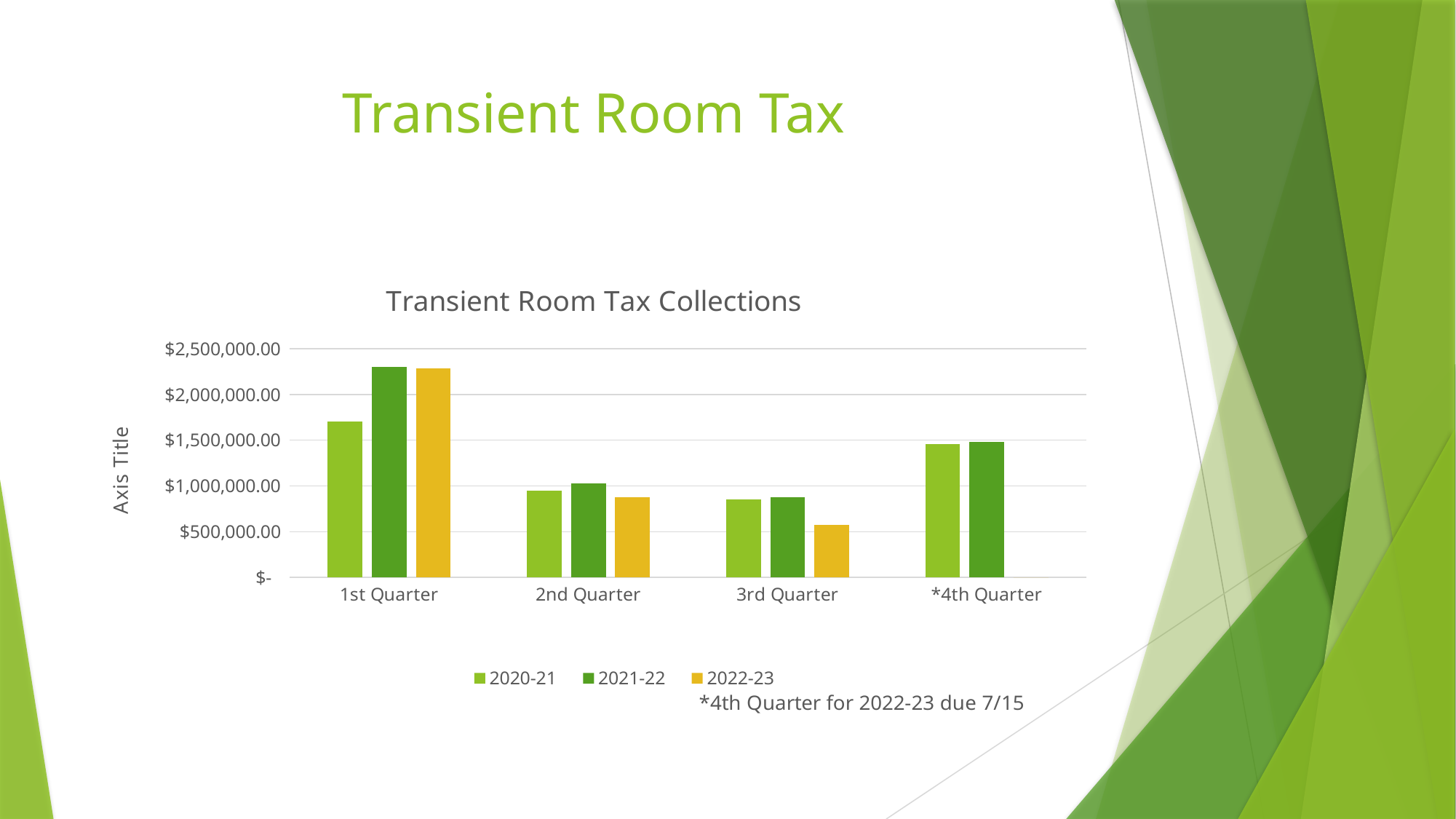
Is the 2021-22 value for 1st Quarter greater or less than $2,000,000.00? greater How many quarter categories are shown on the x axis? 4 Is the 2022-23 value for 3rd Quarter greater or less than $1,000,000.00? less Do the 2022-23 values rise or fall from 1st Quarter to 3rd Quarter? fall In which quarter is the 2020-21 value highest? 1st Quarter How many series does the legend list? 3 What kind of chart is shown on the slide? Bar chart Is the 2020-21 value for 1st Quarter greater or less than $1,500,000.00? greater In 1st Quarter, which is larger: the 2020-21 value or the 2021-22 value? 2021-22 What is the title of the chart? Transient Room Tax Collections In 2nd Quarter, which is larger: the 2020-21 value or the 2022-23 value? 2020-21 In which quarter is the 2022-23 value lowest? 3rd Quarter